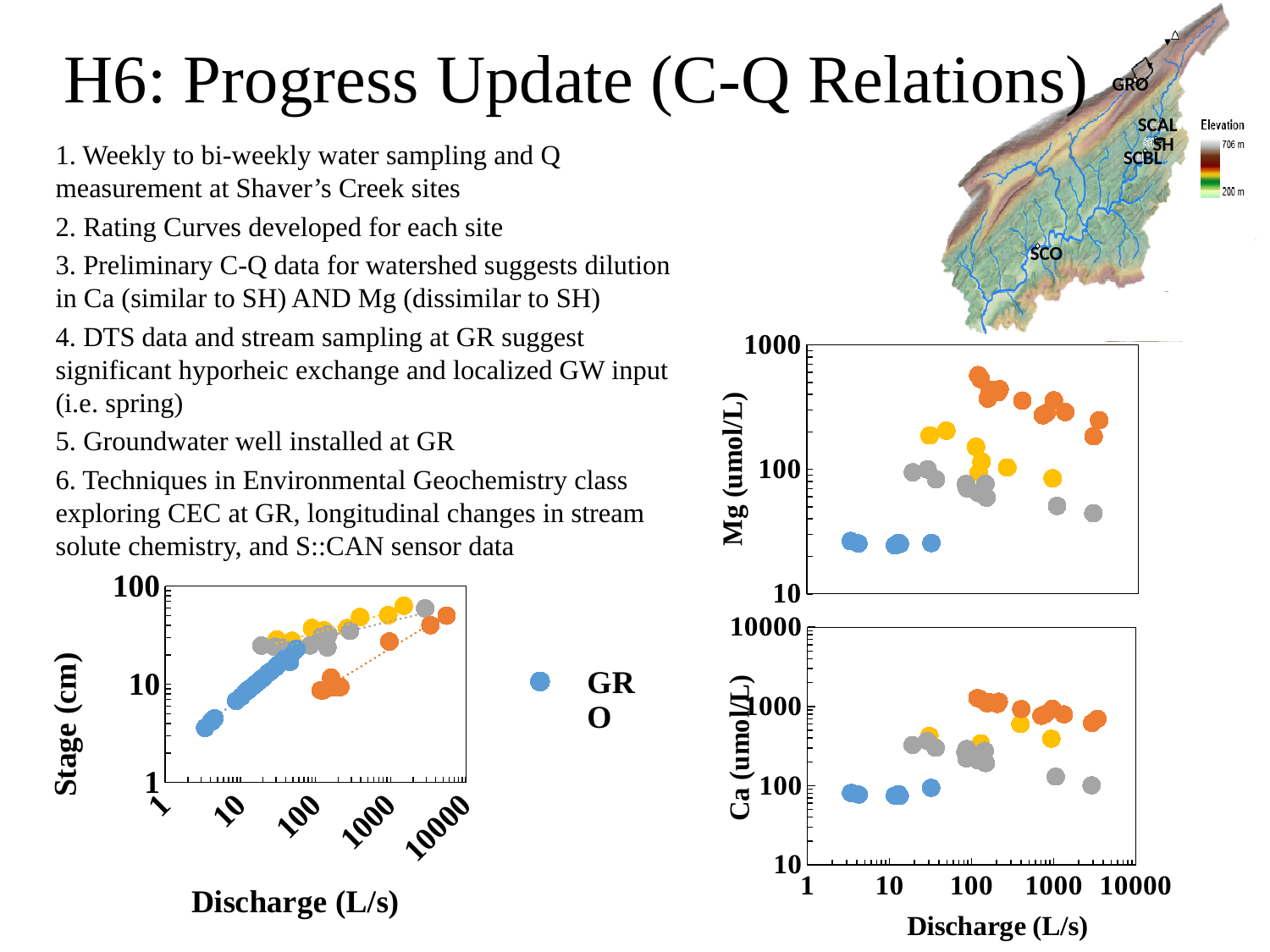
In the Ca (umol/L) chart, are the values for the blue GRO points greater or less than 1000? less In the Mg (umol/L) chart, which series has higher values, the orange points or the blue GRO points? orange What kind of chart is the bottom-left chart with Stage (cm) on the y axis? scatter chart In the Stage (cm) chart, are the blue GRO points at discharges below 10 L/s greater or less than 10 cm? less In the Stage (cm) chart, do the blue GRO points rise or fall as discharge increases? rise In the Mg (umol/L) chart, are the values for the blue GRO points greater or less than 100? less Which series does the legend next to the Stage (cm) chart identify? GRO In the Ca (umol/L) chart, which series has higher values, the gray points or the orange points? orange